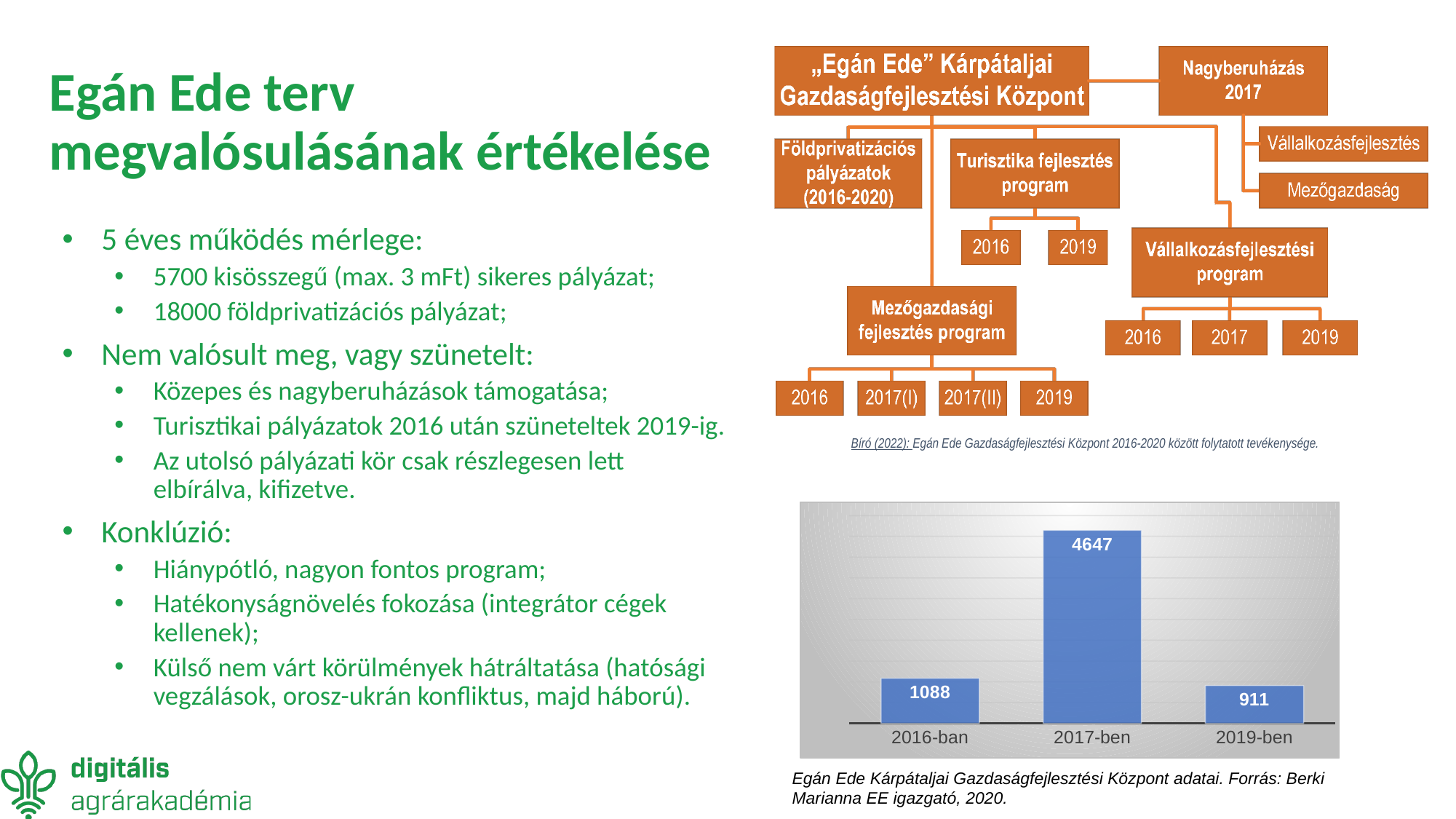
In the bar chart at the bottom right, what is the value for 2016-ban? 1088 What kind of chart is shown at the bottom right of the slide? bar chart According to the caption under the bar chart, who is named as the source of the data? Berki Marianna EE igazgató, 2020 In the bar chart at the bottom right, do the values rise or fall from 2017-ben to 2019-ben? fall In the bar chart at the bottom right, what is the difference between the values for 2017-ben and 2016-ban? 3559 In the bar chart at the bottom right, what is the value for 2017-ben? 4647 In the bar chart at the bottom right, which category has the highest value? 2017-ben In the bar chart at the bottom right, what is the value for 2019-ben? 911 How many bars are shown in the bar chart at the bottom right? 3 In the bar chart at the bottom right, what is the difference between the values for 2016-ban and 2019-ben? 177 In the bar chart at the bottom right, which is larger, the value for 2016-ban or the value for 2019-ben? 2016-ban In the bar chart at the bottom right, which category has the lowest value? 2019-ben